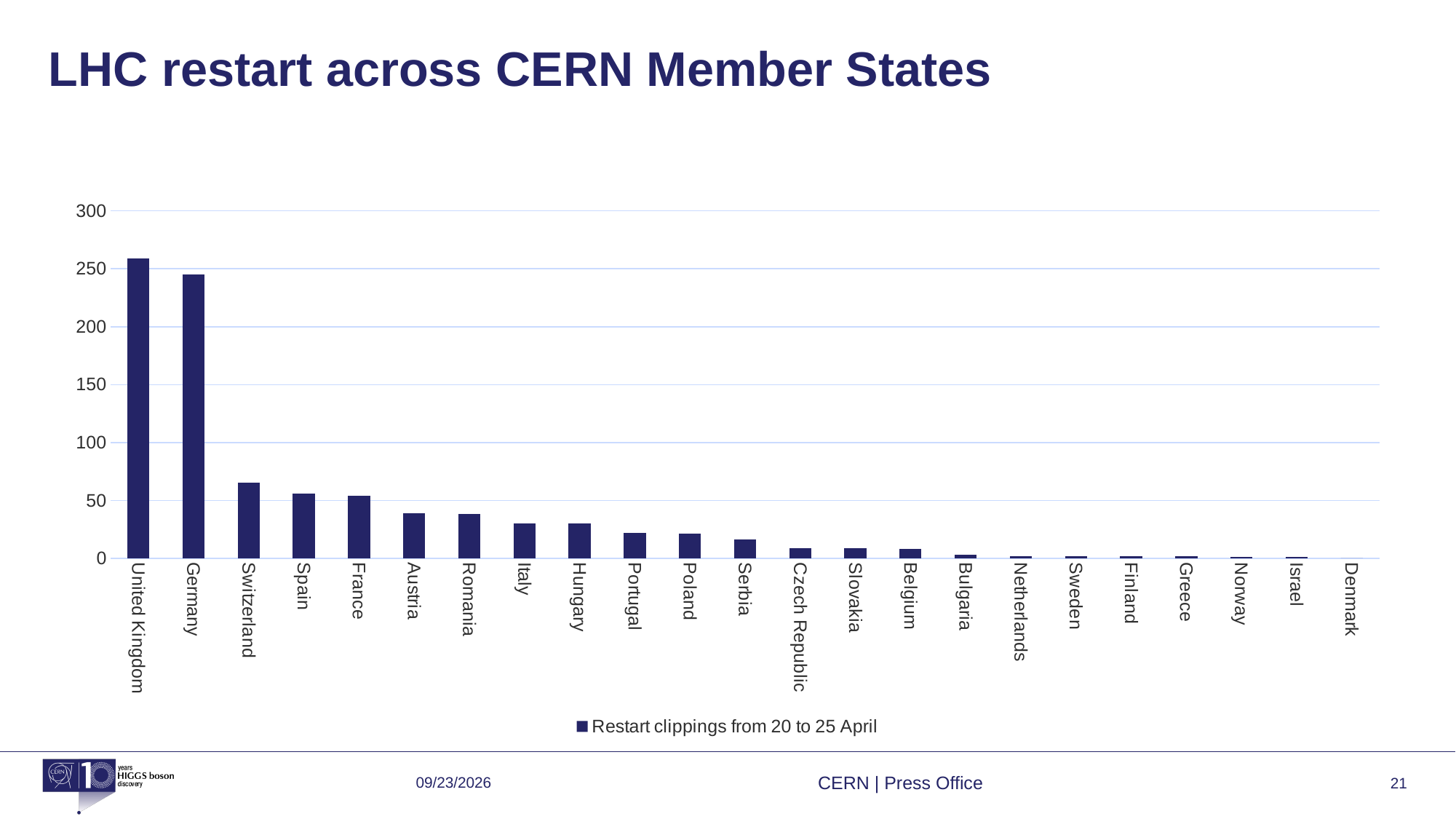
Is the value for Switzerland greater or less than 50? greater Which country has the highest number of restart clippings? United Kingdom Is the value for Germany greater or less than 250? less How many series does the legend list? 1 What is the legend entry for the series shown in the chart? Restart clippings from 20 to 25 April Which has more restart clippings, the United Kingdom or Germany? United Kingdom Which has more restart clippings, Switzerland or Spain? Switzerland Do the values rise or fall moving from left to right along the x axis? fall What kind of chart is shown on the slide? bar chart Is the value for the United Kingdom greater or less than 250? greater How many countries are shown on the x axis of the chart? 23